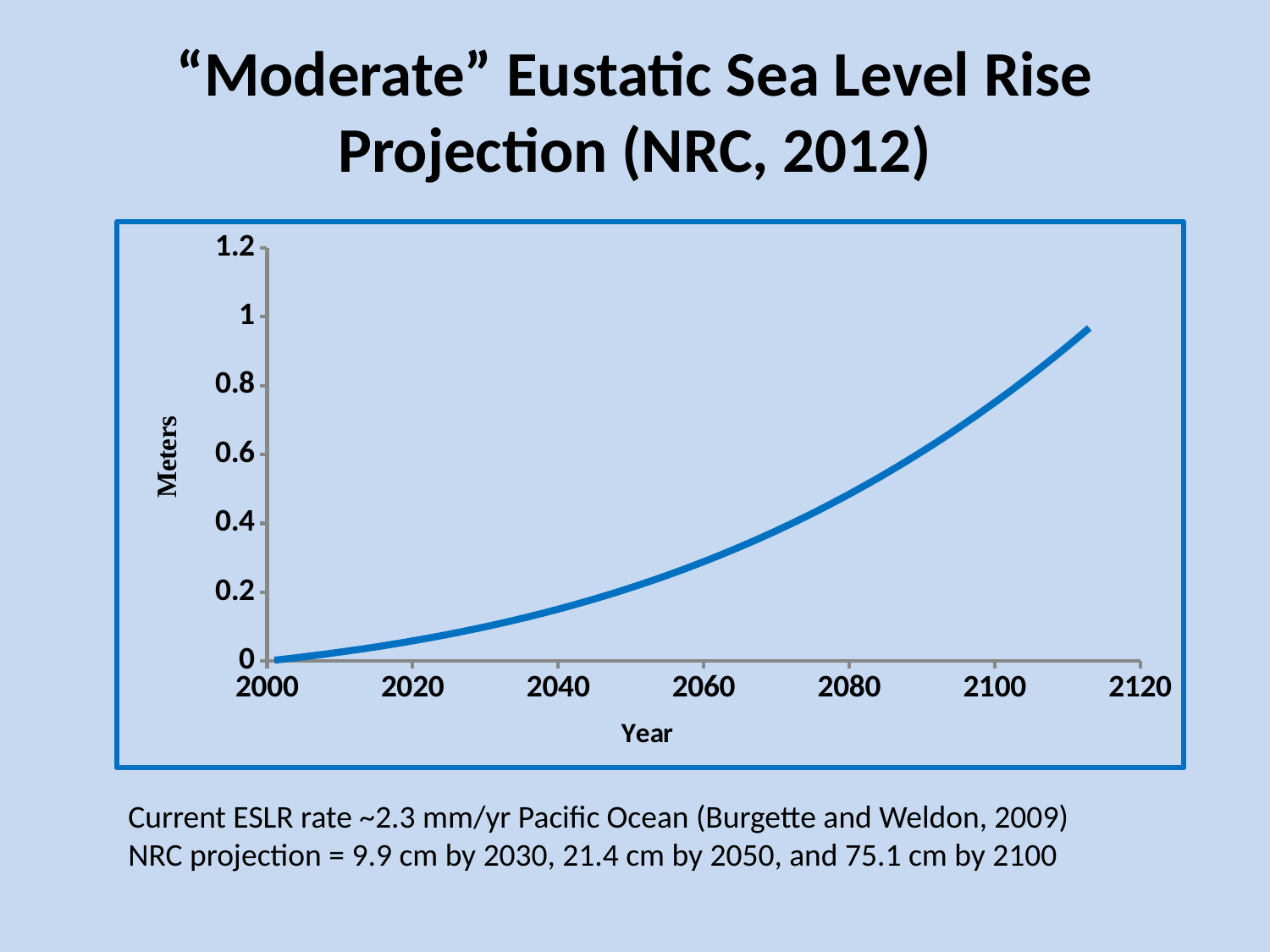
Is the projected value for the year 2080 greater or less than 0.4 meters? greater According to the text on the slide, what is the NRC projected sea level rise by 2050? 21.4 cm Does the projected sea level rise increase or decrease as the year increases along the x axis? increase What is the title of the chart on the slide? "Moderate" Eustatic Sea Level Rise Projection (NRC, 2012) Is the projected value for the year 2060 greater or less than 0.2 meters? greater Is the projected value for the year 2020 greater or less than 0.2 meters? less Which year has the higher projected sea level rise, 2040 or 2100? 2100 What is the label of the y axis of the chart? Meters What kind of chart is shown on the slide? line chart